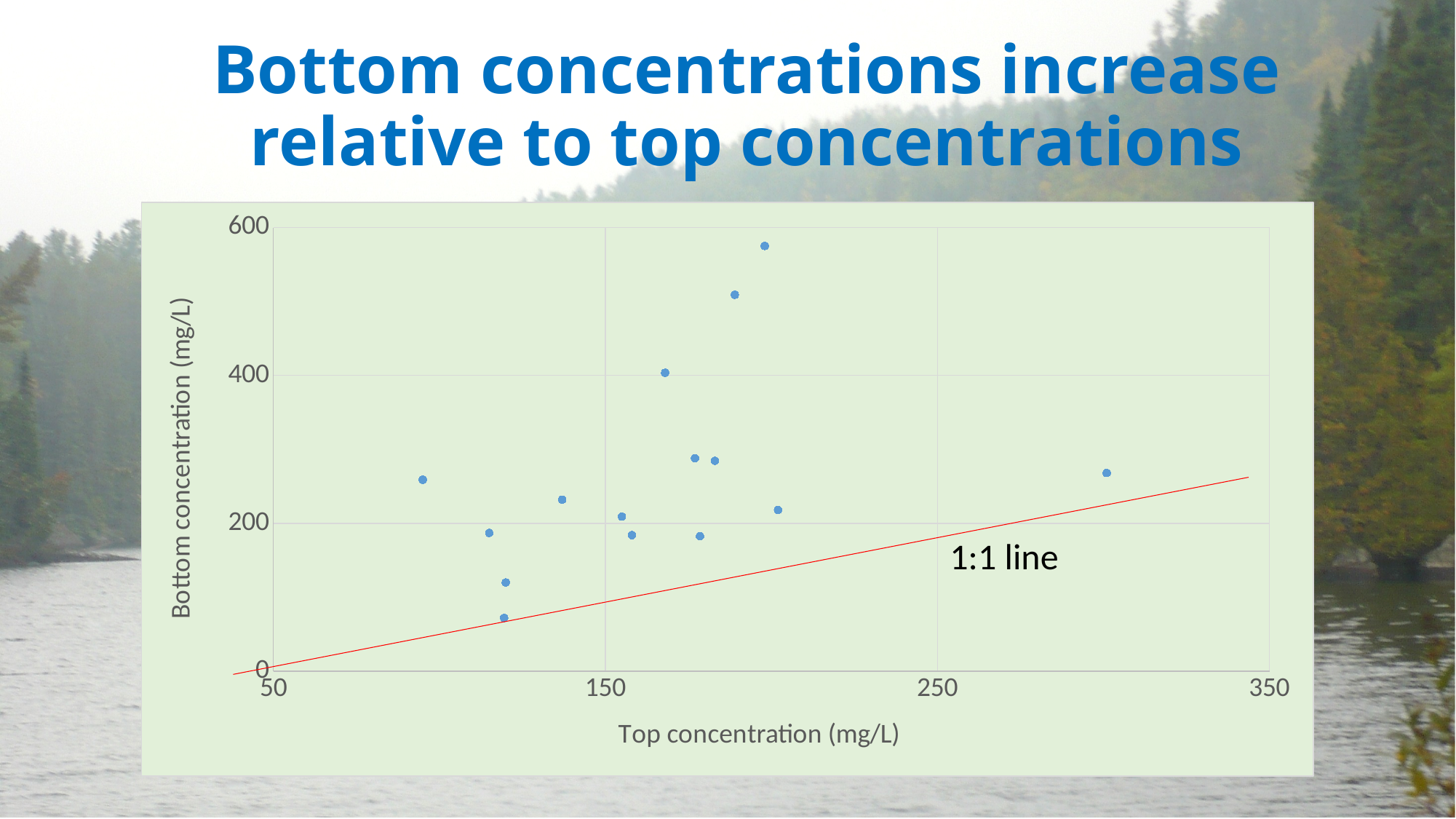
Is the highest bottom concentration plotted greater or less than 400? greater Which is larger: the highest bottom concentration plotted or the highest top concentration plotted? The highest bottom concentration How many data points are plotted on the chart? 15 Is the smallest top concentration plotted greater or less than 150? less Is the lowest bottom concentration plotted greater or less than 200? less What kind of chart is shown on the slide? Scatter chart What is the title of the chart's y axis? Bottom concentration (mg/L) What is the maximum value shown on the y axis? 600 What is the title of the chart's x axis? Top concentration (mg/L)